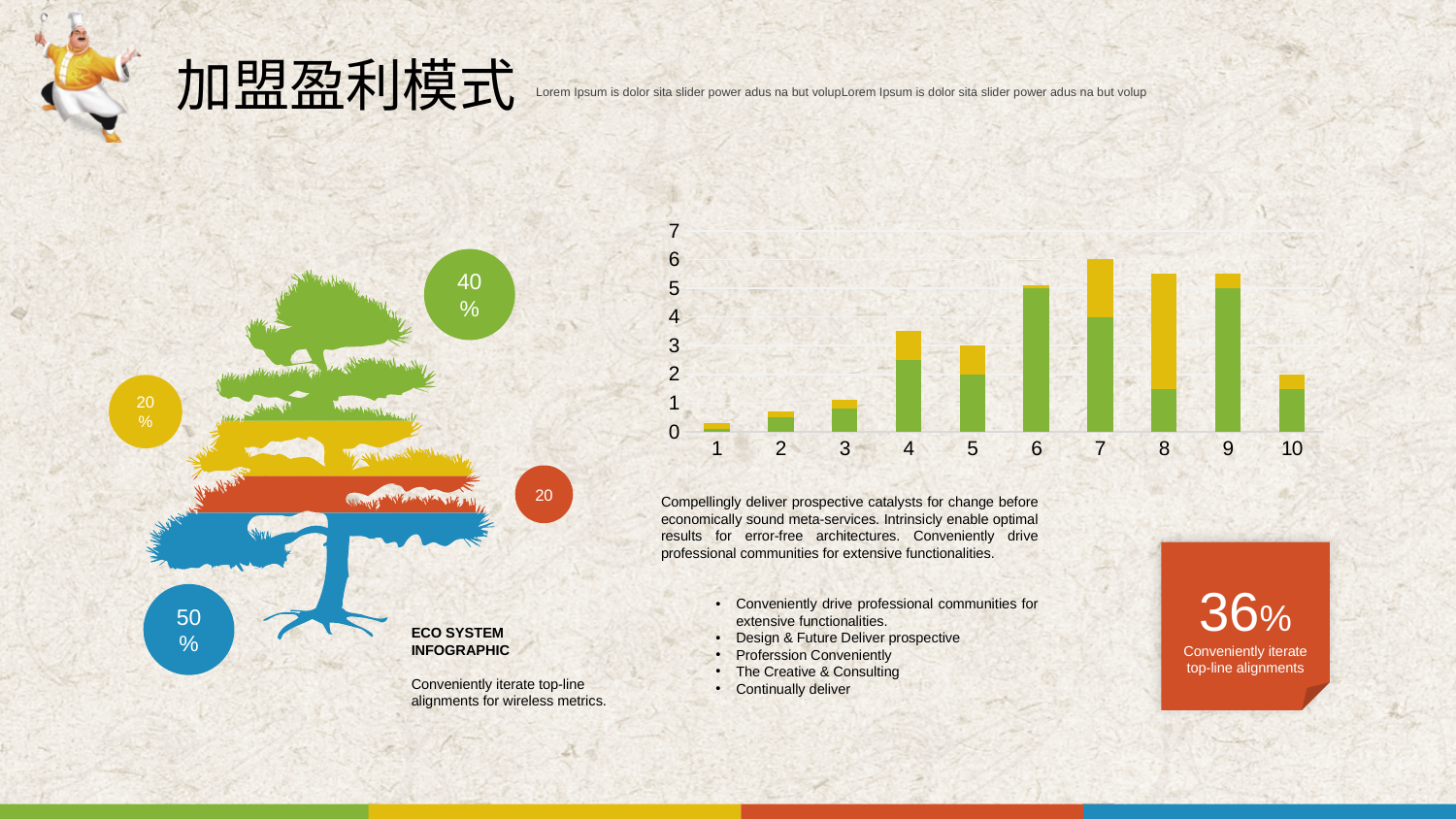
Is the total value of the bar for category 10 greater or less than 3? less Which category has the shortest stacked bar in the chart? 1 Do the bar totals rise or fall from category 1 to category 7? rise Which bar is taller, category 4 or category 5? 4 Is the total value of the bar for category 4 greater or less than 3? greater Which bar is taller, category 9 or category 10? 9 What is the highest value shown on the y axis of the chart? 7 Which category has the tallest stacked bar in the chart? 7 How many categories are shown on the x axis of the bar chart? 10 Is the total value of the bar for category 7 greater or less than 5? greater What kind of chart is shown on the slide? bar chart